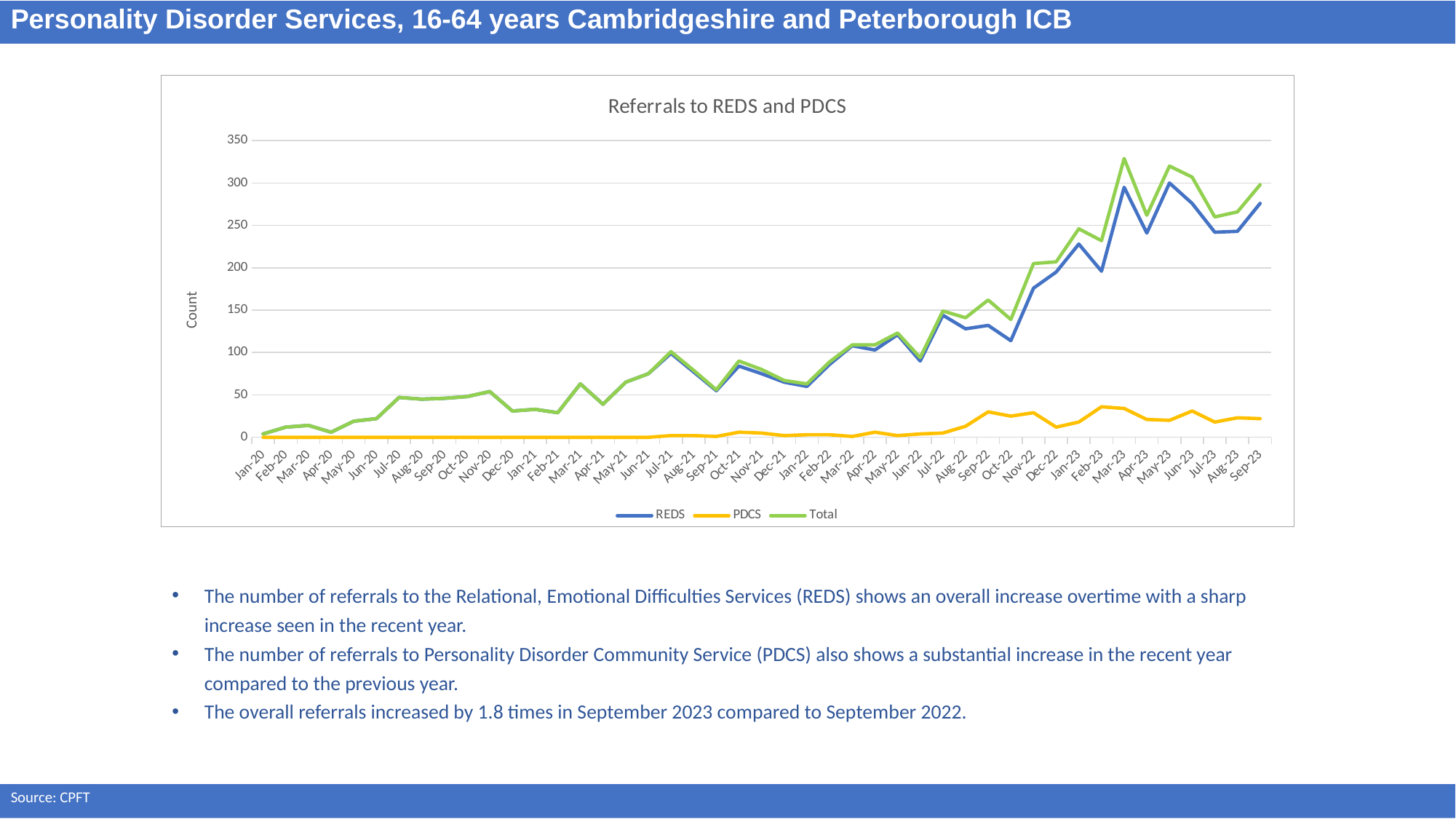
Is the Total value for Mar-23 greater or less than 300? greater Which is larger for the Total series, the value in Sep-22 or the value in Sep-23? Sep-23 Is the REDS value for Sep-23 greater or less than 250? greater What is the title of the chart? Referrals to REDS and PDCS What kind of chart is shown on the slide? Line chart How many monthly points are plotted along the x axis, from Jan-20 to Sep-23? 45 Does the Total series generally rise or fall from Jan-20 to Sep-23? Rise Which is larger in Sep-23, the REDS value or the PDCS value? REDS In which month does the Total series reach its highest value? Mar-23 How many series does the legend of the chart list? 3 Is the PDCS value for Feb-23 greater or less than 50? less What is the label on the vertical axis of the chart? Count